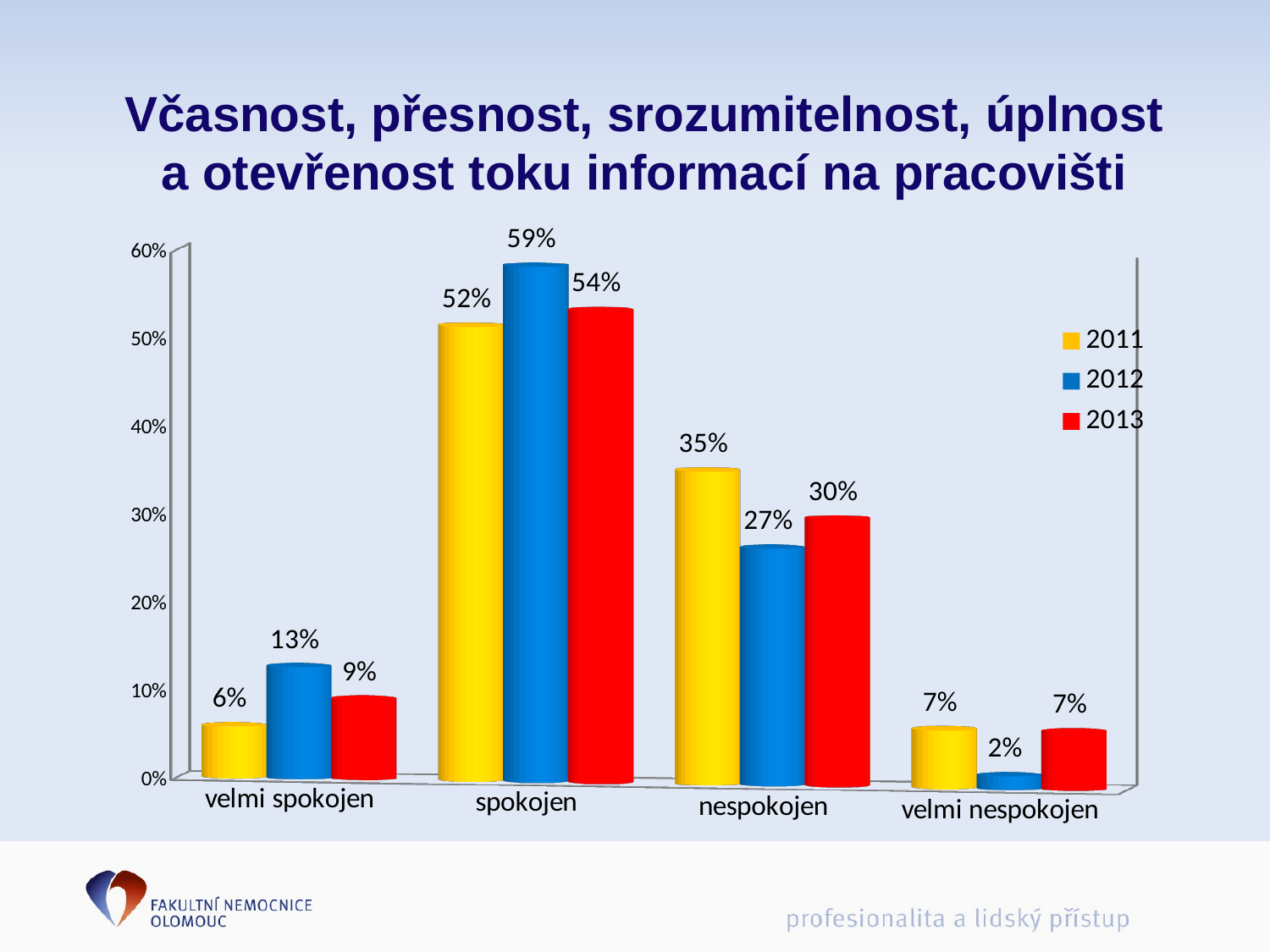
What is the value for 'nespokojen' in 2013? 30% What kind of chart is shown on the slide? bar chart What is the value for 'spokojen' in 2012? 59% What is the difference between the 2011 and 2012 values for 'nespokojen'? 8% Which colour represents the 2013 series in the legend? red Is the 2013 value for 'spokojen' greater or less than 50%? greater What is the value for 'velmi nespokojen' in 2012? 2% How many series does the legend list? 3 Which is larger for 'velmi spokojen': the 2012 value or the 2013 value? 2012 Which category has the highest value for the 2011 series? spokojen How many categories are shown on the x axis? 4 Which category has the lowest value for the 2013 series? velmi nespokojen